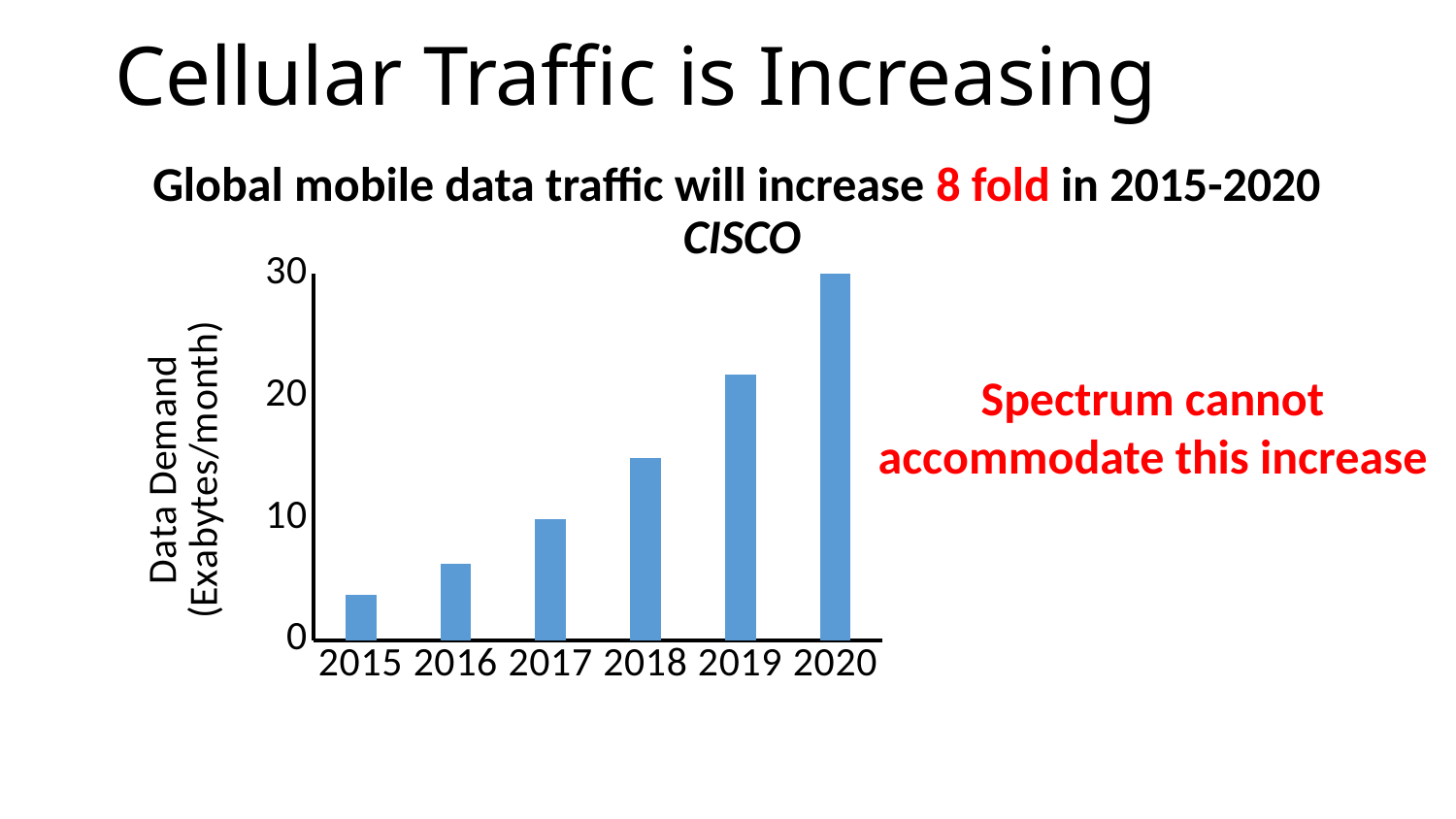
What is the label of the y axis of the chart? Data Demand (Exabytes/month) How many years are plotted on the x axis of the chart? 6 Is the value for 2016 greater or less than 10? less Do the values in the chart rise or fall from 2015 to 2020? rise Which year has the lowest data demand in the chart? 2015 Which year has the highest data demand in the chart? 2020 Which year has the larger data demand, 2018 or 2019? 2019 What kind of chart is shown on the slide? bar chart Is the value for 2019 greater or less than 20? greater Is the value for 2018 greater or less than 10? greater